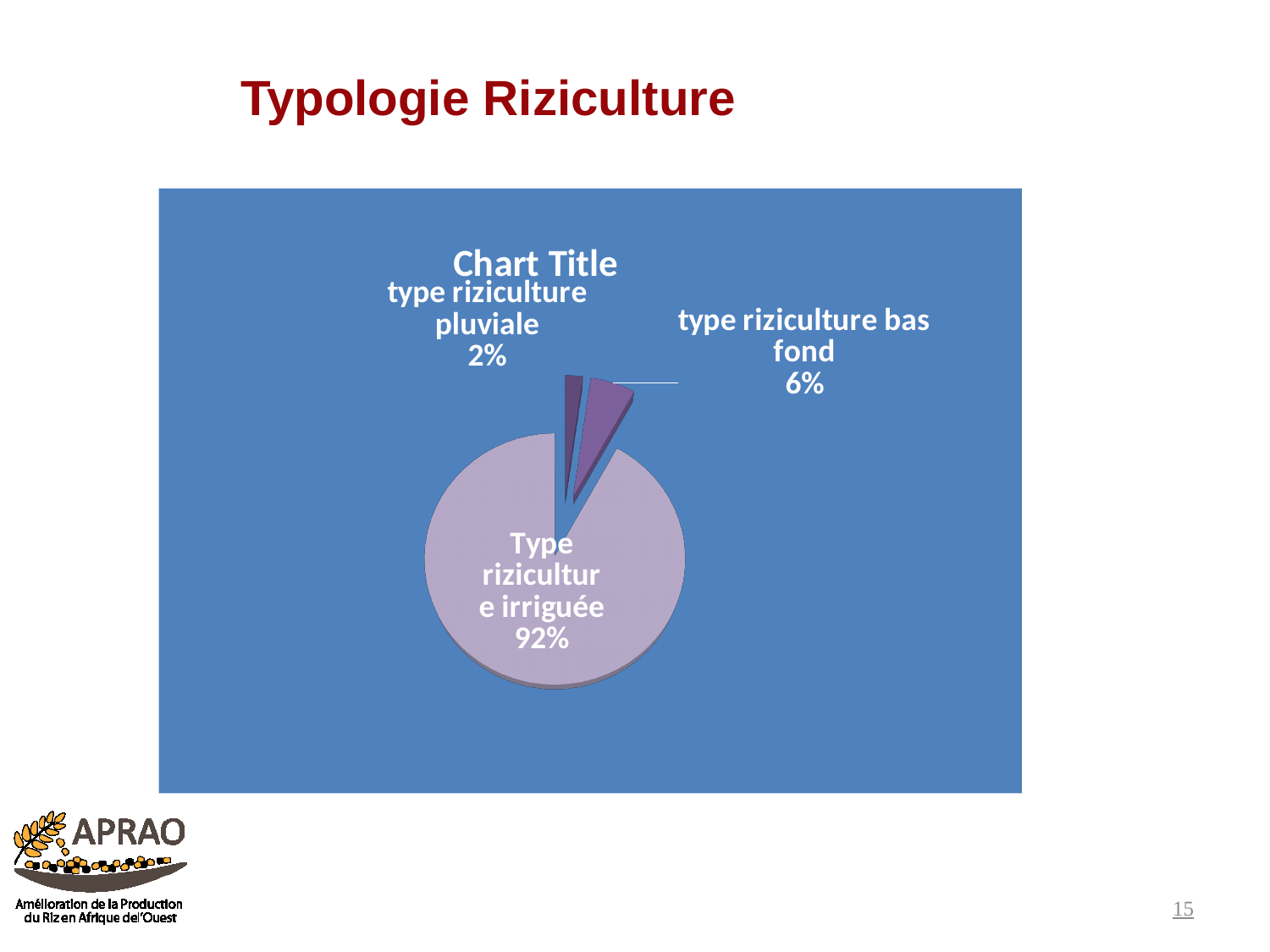
Which category has the smallest slice of the pie? type riziculture pluviale What is the title shown above the pie chart? Chart Title What share of the pie does "Type riziculture irriguée" represent? 92% How many slices does the pie chart have? 3 What is the difference in percentage points between "type riziculture bas fond" and "type riziculture pluviale"? 4% What kind of chart is shown on the slide? pie chart What share of the pie does "type riziculture pluviale" represent? 2% What is the difference in percentage points between "Type riziculture irriguée" and "type riziculture bas fond"? 86% What is the title of the slide? Typologie Riziculture Which is larger, the share for "type riziculture bas fond" or the share for "type riziculture pluviale"? type riziculture bas fond What share of the pie does "type riziculture bas fond" represent? 6% Which category has the largest slice of the pie? Type riziculture irriguée